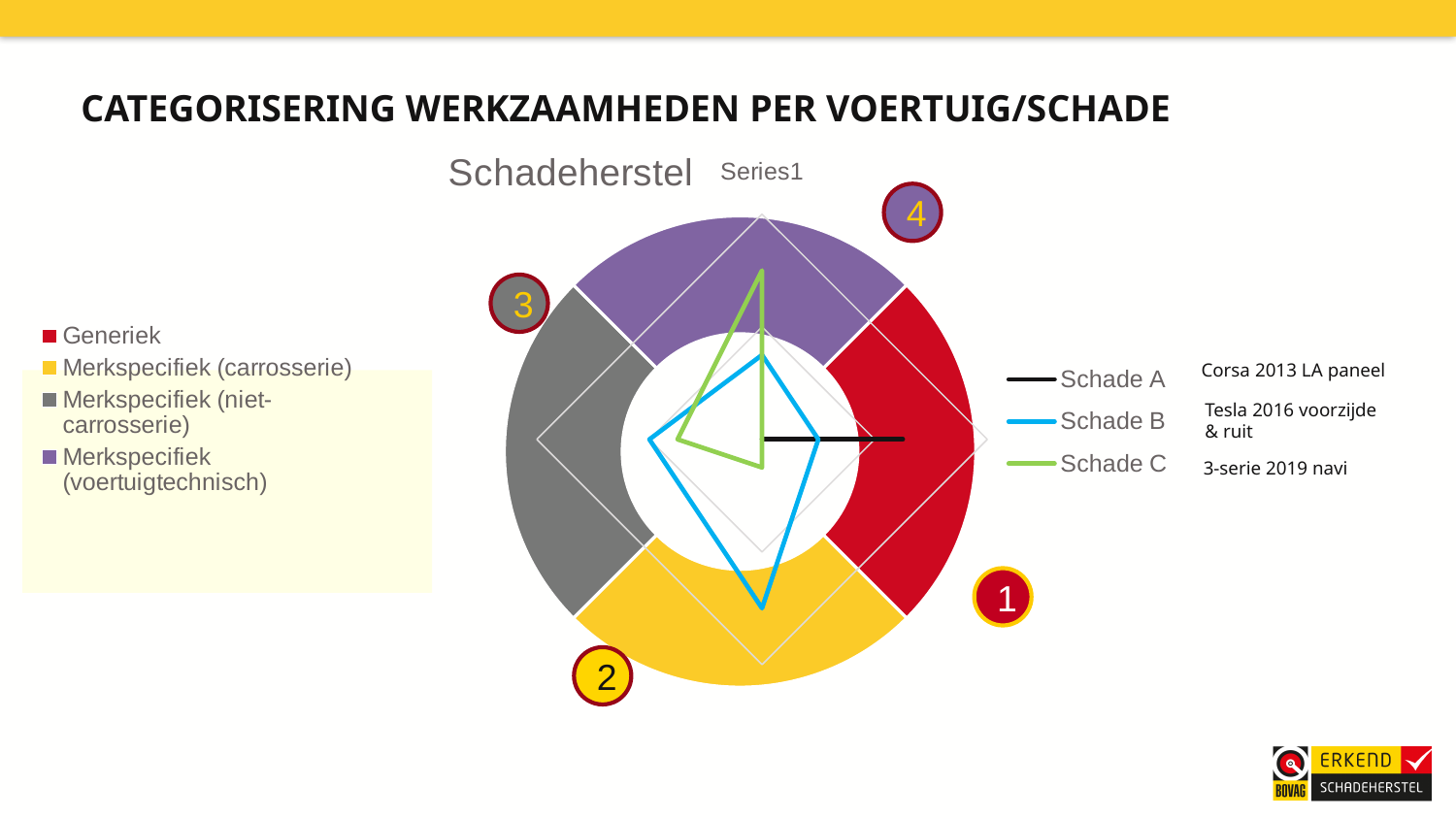
Which vehicle description is listed next to Schade A? Corsa 2013 LA paneel Which colour represents the category Generiek in the doughnut chart? Red What kind of chart is the ring-shaped chart titled Schadeherstel? Doughnut chart How many series does the legend on the right (Schade A, B, C) list? 3 Which vehicle description is listed next to Schade C? 3-serie 2019 navi Which category in the doughnut chart is shown in purple? Merkspecifiek (voertuigtechnisch) Which series in the radar chart is drawn with a green line? Schade C What kind of chart is the overlaid chart showing Schade A, Schade B and Schade C? Radar chart Which category in the doughnut chart is shown in yellow? Merkspecifiek (carrosserie) How many categories does the legend on the left of the doughnut chart list? 4 What is the title of the chart on the slide? Schadeherstel Which series in the radar chart is drawn with a blue line? Schade B